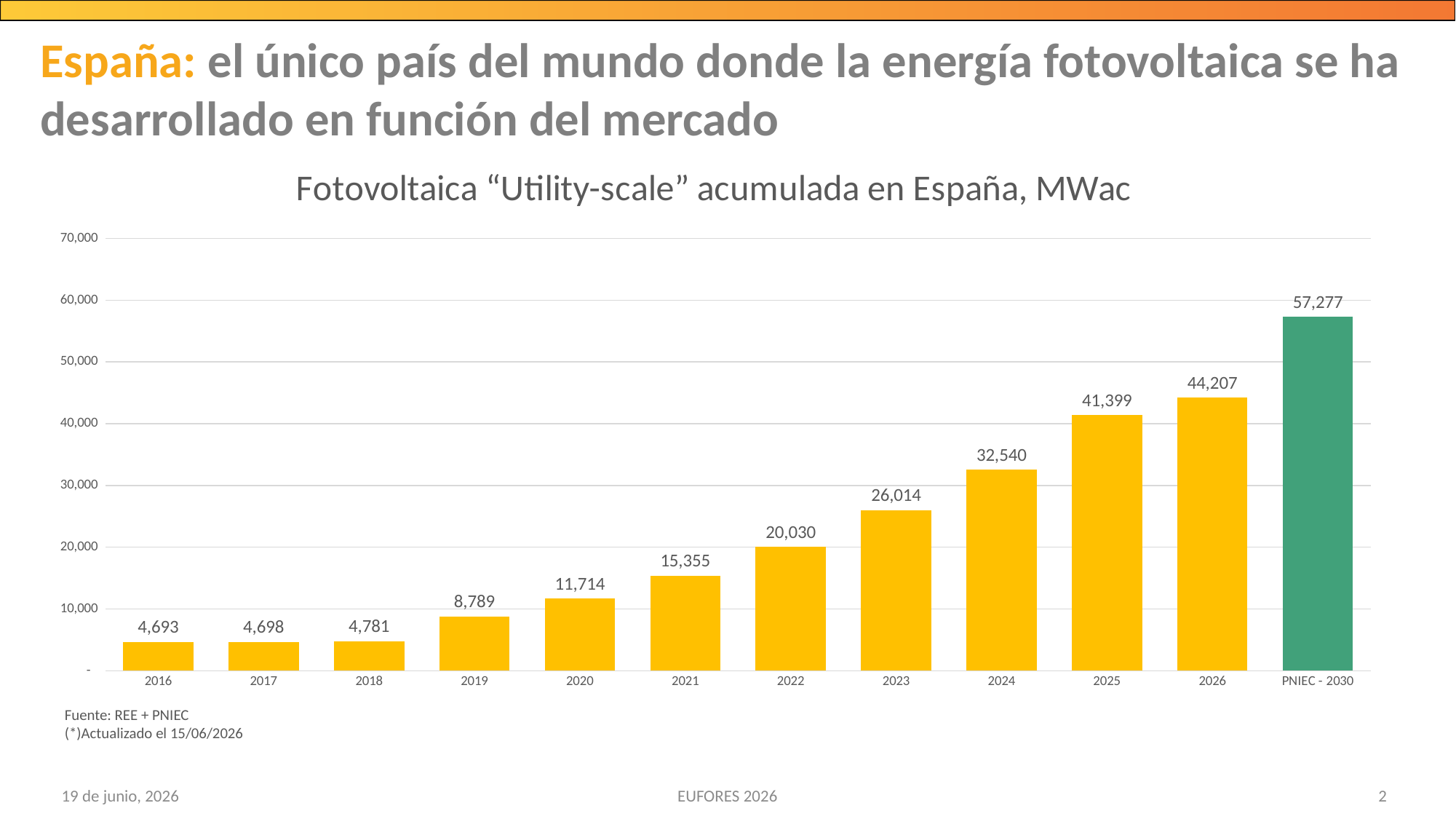
What is the value for 2019? 8,789 What kind of chart is shown? bar chart What is the difference between the values for 2024 and 2023? 6,526 Which category has the highest value? PNIEC - 2030 What is the title of the chart? Fotovoltaica "Utility-scale" acumulada en España, MWac Which category has the lowest value? 2016 What is the difference between the values for 2026 and 2025? 2,808 Is the value for 2025 greater or less than 40,000? greater Which is larger, the value for 2021 or the value for 2020? 2021 What is the value for 2022? 20,030 What is the value for PNIEC - 2030? 57,277 How many categories are shown on the x axis? 12